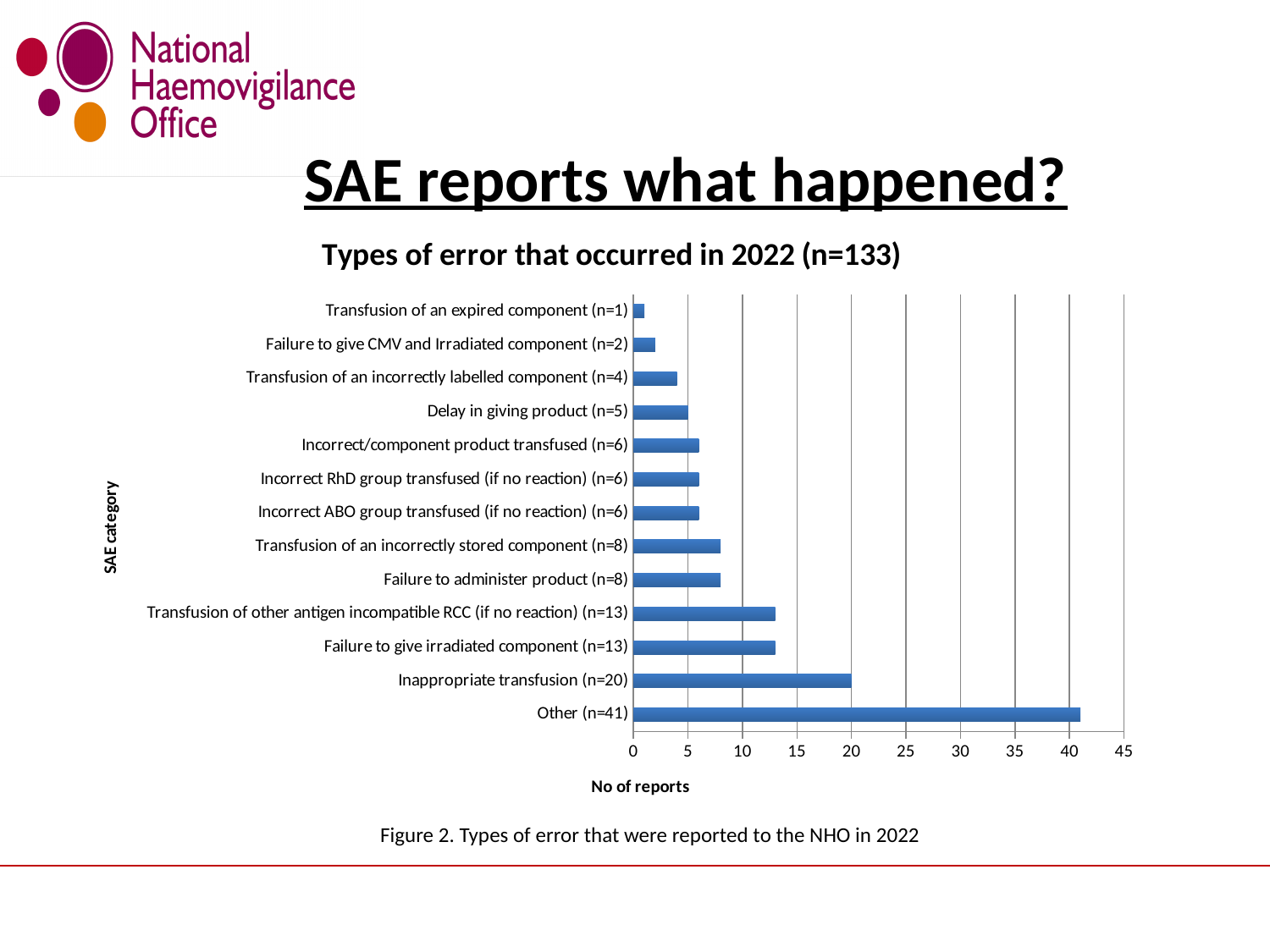
How many reports were there for Delay in giving product? 5 Which has more reports: Transfusion of an incorrectly stored component or Transfusion of an incorrectly labelled component? Transfusion of an incorrectly stored component What is the difference in number of reports between Other and Inappropriate transfusion? 21 What is the title of the chart? Types of error that occurred in 2022 (n=133) What type of chart is shown on the slide? Bar chart How many SAE categories are plotted in the chart? 13 Is the value for Other greater or less than 40? greater What is the label on the x axis of the chart? No of reports How many reports were there for Failure to give irradiated component? 13 Which SAE category has the lowest number of reports? Transfusion of an expired component (n=1) How many reports were there for Inappropriate transfusion? 20 Which SAE category has the highest number of reports? Other (n=41)